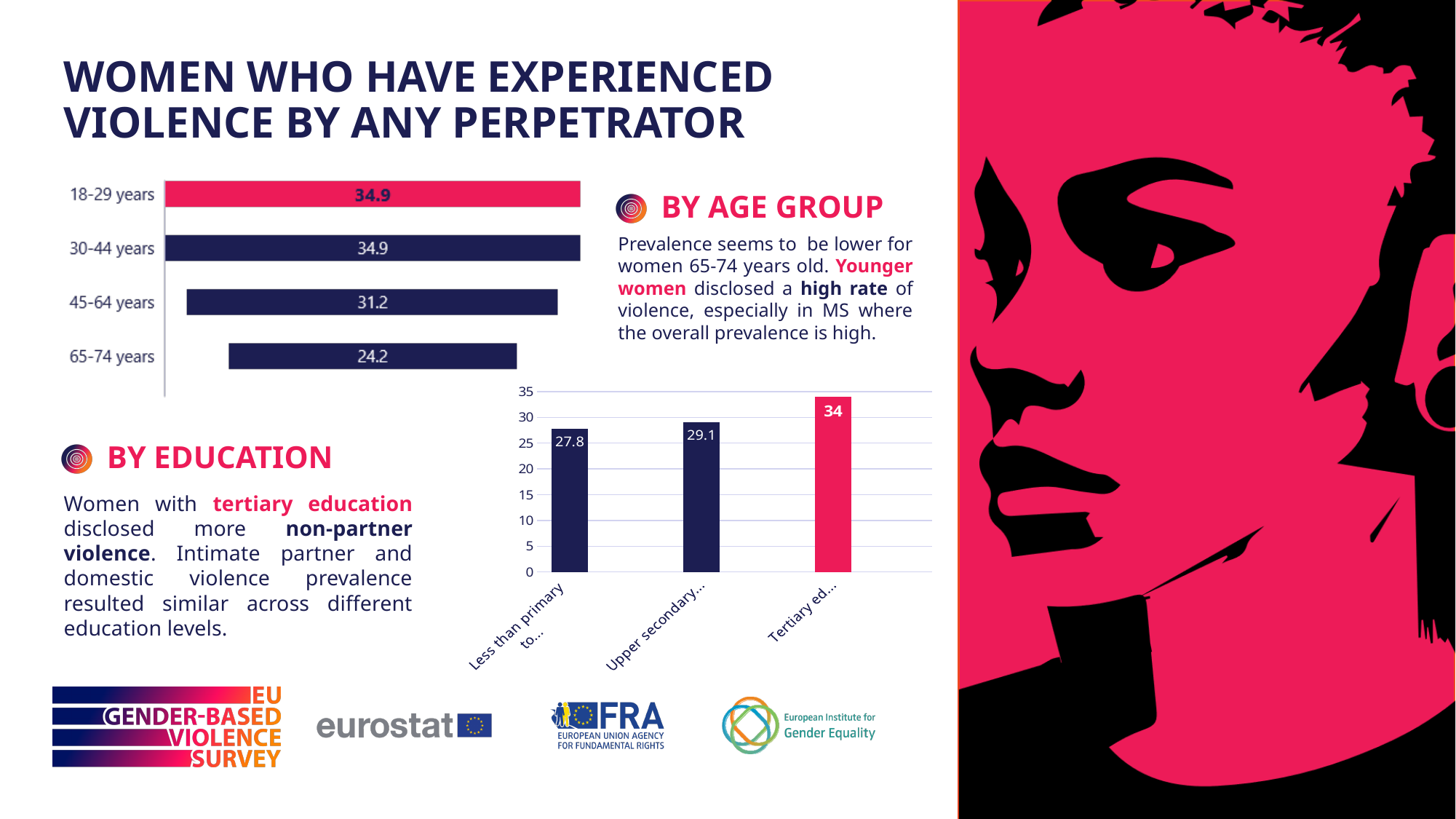
In the education chart, what is the value for Tertiary education? 34 In the age group chart, what is the value for 45-64 years? 31.2 In the education chart, do the values rise or fall from Less than primary to Tertiary education? Rise In the education chart, which education level has the highest value? Tertiary education In the age group chart, what is the value for 65-74 years? 24.2 In the education chart, what is the value for Upper secondary? 29.1 In the age group chart, which age group has the lowest value? 65-74 years In the education chart, what is the difference between the values for Tertiary education and Less than primary? 6.2 How many age groups are shown in the age group chart? 4 In the age group chart, which is larger: the value for 45-64 years or the value for 65-74 years? 45-64 years In the age group chart, what is the difference between the values for 30-44 years and 65-74 years? 10.7 What type of chart is the age group chart? Bar chart